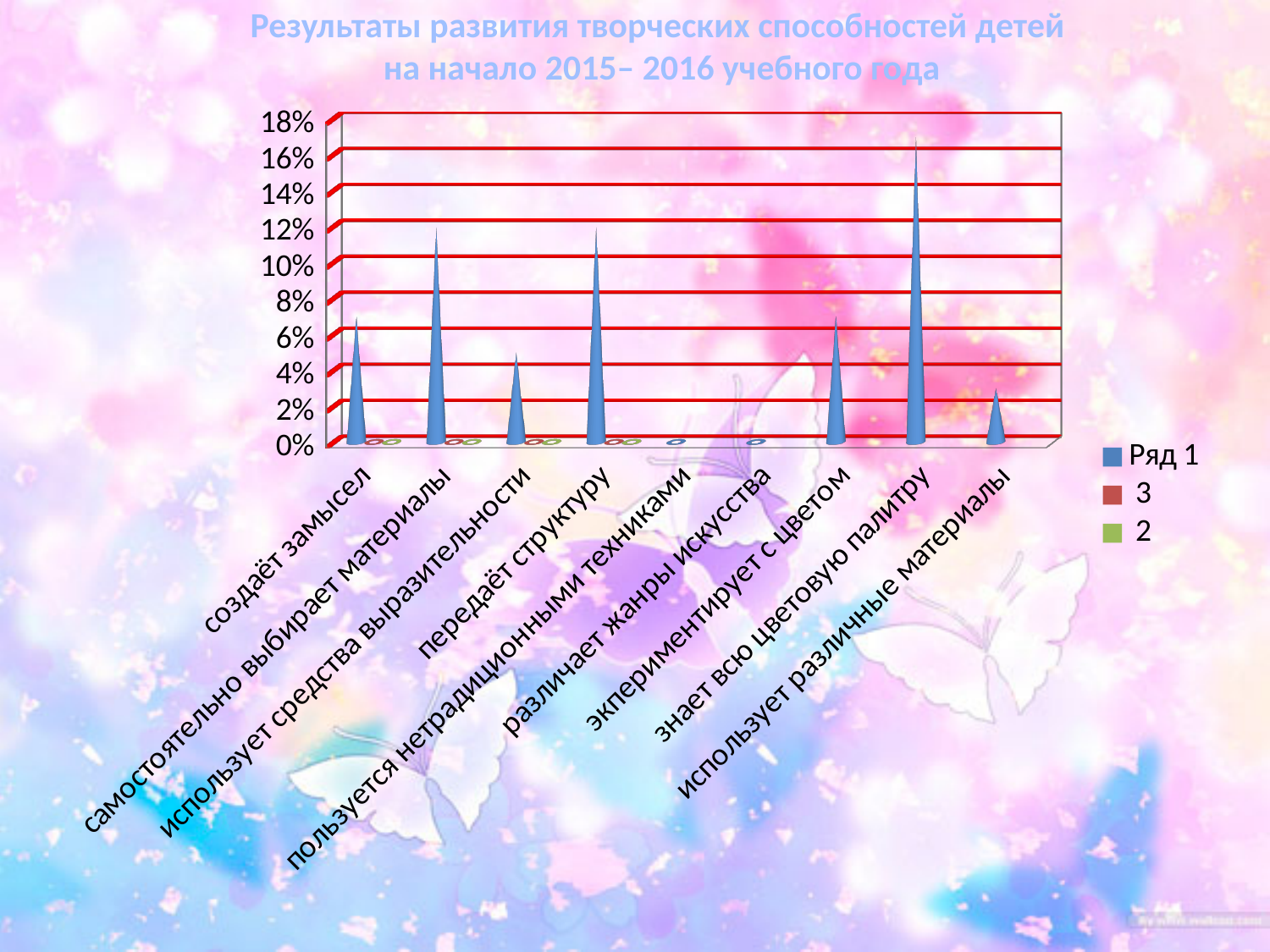
How many categories are shown along the x axis of the chart? 9 Is the value for 'использует различные материалы' greater or less than 4%? less Is the value for 'самостоятельно выбирает материалы' greater or less than 10%? greater Which is larger, the value for 'экспериментирует с цветом' or the value for 'использует различные материалы'? экспериментирует с цветом Which category has the highest value in the chart? знает всю цветовую палитру What kind of chart is shown on the slide? bar chart What is the first entry listed in the chart legend? Ряд 1 Is the value for 'знает всю цветовую палитру' greater or less than 14%? greater How many series does the chart legend list? 3 Which is larger, the value for 'знает всю цветовую палитру' or the value for 'создаёт замысел'? знает всю цветовую палитру